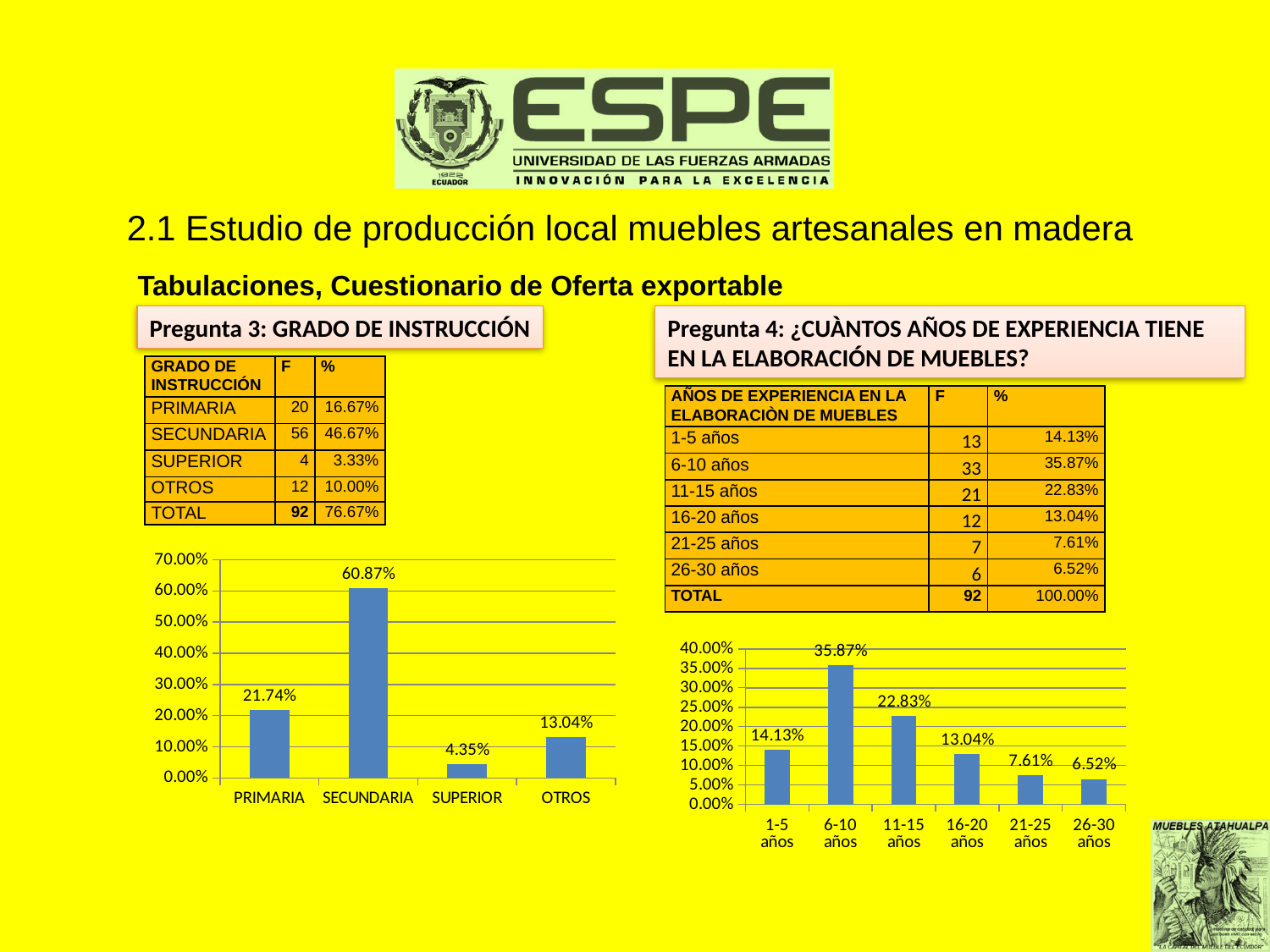
In the Pregunta 3 (Grado de Instrucción) chart, what is the value for SECUNDARIA? 60.87% In the Pregunta 4 (años de experiencia) chart, what is the value for 11-15 años? 22.83% In the Pregunta 4 (años de experiencia) chart, do the values rise or fall from 6-10 años to 26-30 años? fall In the Pregunta 4 (años de experiencia) chart, which category has the highest value? 6-10 años What kind of chart is used for Pregunta 3 (Grado de Instrucción)? bar chart In the Pregunta 3 (Grado de Instrucción) chart, what is the difference between the values for SECUNDARIA and PRIMARIA? 39.13% In the Pregunta 3 (Grado de Instrucción) chart, is the value for OTROS greater or less than 10.00%? greater In the Pregunta 4 (años de experiencia) chart, how many categories are shown on the x axis? 6 In the Pregunta 3 (Grado de Instrucción) chart, how many categories are shown on the x axis? 4 In the Pregunta 4 (años de experiencia) chart, which is larger, the value for 1-5 años or the value for 16-20 años? 1-5 años In the Pregunta 3 (Grado de Instrucción) chart, which category has the lowest value? SUPERIOR In the Pregunta 4 (años de experiencia) chart, what is the difference between the values for 6-10 años and 26-30 años? 29.35%